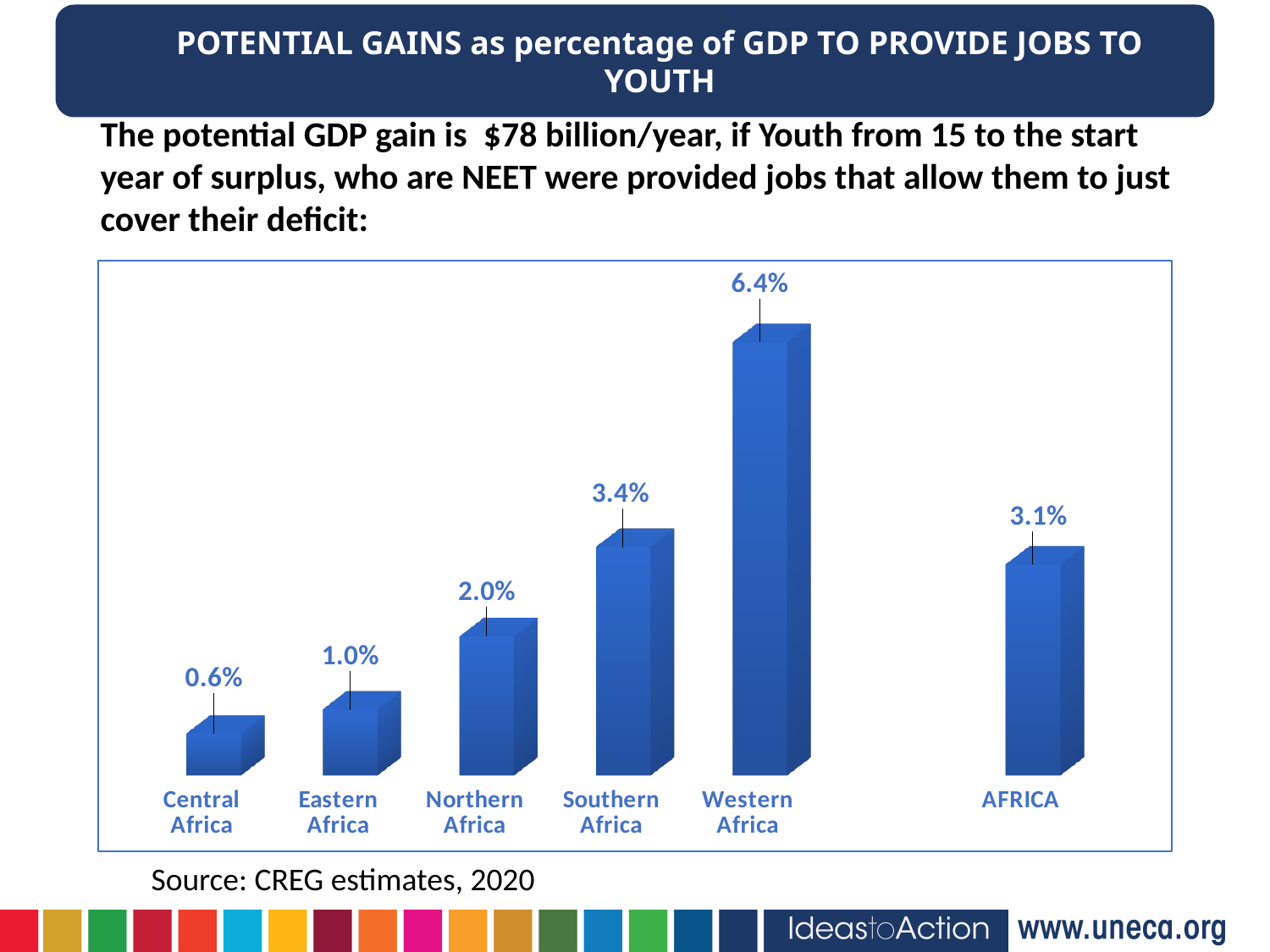
How many categories are shown in the chart? 6 Which category has the lowest value? Central Africa Which is larger, the value for Southern Africa or the value for AFRICA? Southern Africa What is the value for Northern Africa? 2.0% What is the difference between the values for Eastern Africa and Central Africa? 0.4% What is the source cited below the chart? CREG estimates, 2020 What is the value for AFRICA? 3.1% What kind of chart is shown on the slide? Bar chart Which category has the highest value? Western Africa What is the value for Western Africa? 6.4% What is the value for Central Africa? 0.6% What is the difference between the values for Western Africa and Southern Africa? 3.0%